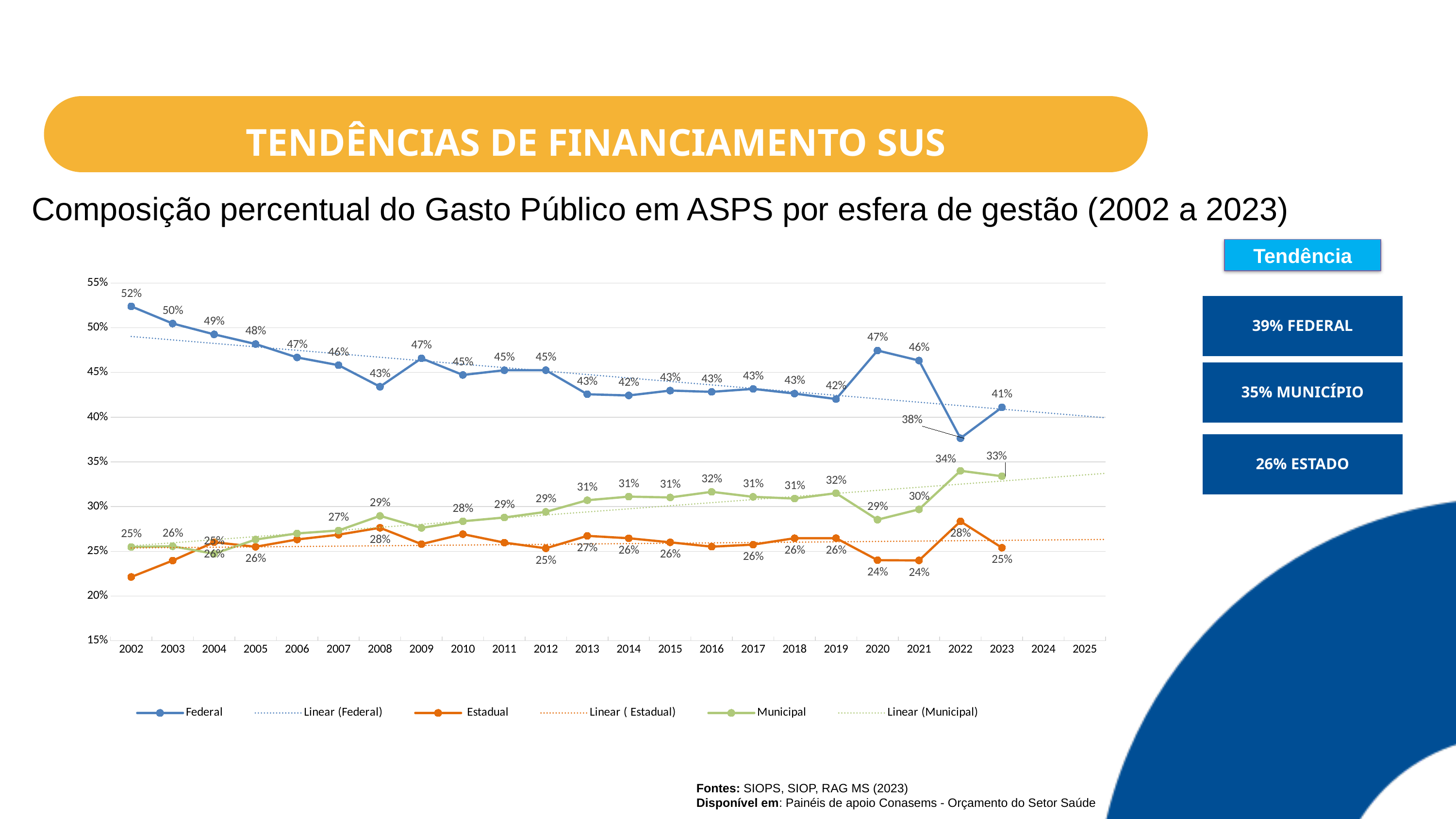
What is the Estadual share in 2020? 24% In which year is the Federal share lowest? 2022 In which year is the Federal share highest? 2002 In 2023, which is larger, the Municipal share or the Estadual share? Municipal What is the Municipal share in 2022? 34% Does the Federal series generally rise or fall from 2002 to 2023? Fall Is the Estadual value for 2002 greater or less than 25%? less How many entries does the chart legend list? 6 By how many percentage points did the Federal share fall from 2002 to 2023? 11 percentage points What is the Federal share in 2023? 41% What is the Federal share in 2002? 52% What kind of chart is shown on the slide? Line chart